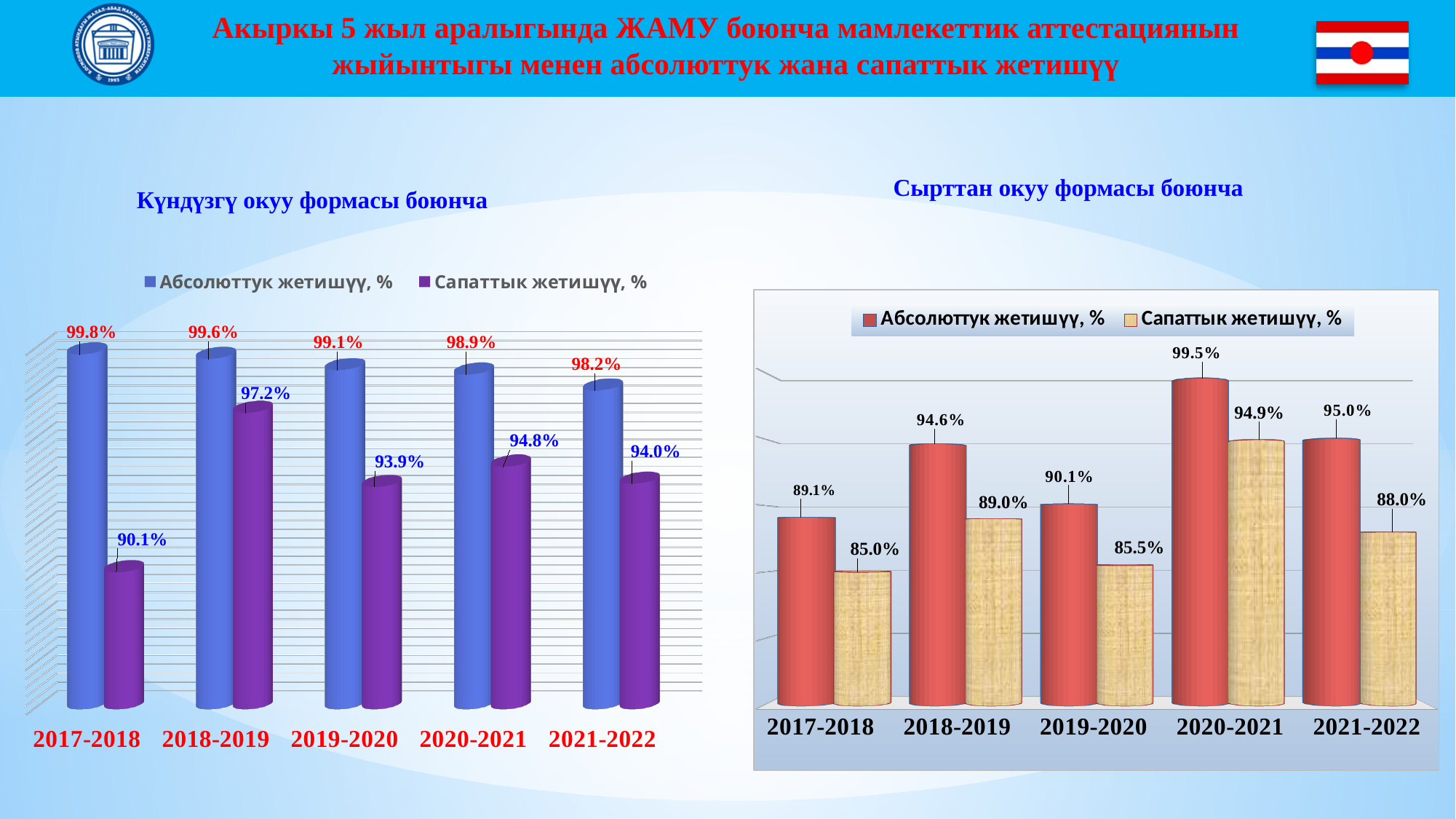
In the right chart (Сырттан окуу формасы боюнча), what is the difference between Абсолюттук жетишүү, % for 2020-2021 and 2017-2018? 10.4% In the left chart (Күндүзгү окуу формасы боюнча), what is the value of Сапаттык жетишүү, % for 2018-2019? 97.2% In the left chart (Күндүзгү окуу формасы боюнча), what is the difference between Абсолюттук жетишүү, % and Сапаттык жетишүү, % for 2021-2022? 4.2% How many years are shown on the x axis of the right chart (Сырттан окуу формасы боюнча)? 5 How many series does the legend of the left chart (Күндүзгү окуу формасы боюнча) list? 2 In the left chart (Күндүзгү окуу формасы боюнча), does Абсолюттук жетишүү, % rise or fall from 2017-2018 to 2021-2022? fall In the right chart (Сырттан окуу формасы боюнча), which is larger: Абсолюттук жетишүү, % for 2018-2019 or for 2021-2022? 2021-2022 In the left chart (Күндүзгү окуу формасы боюнча), which year has the lowest Сапаттык жетишүү, % value? 2017-2018 In the right chart (Сырттан окуу формасы боюнча), what is the value of Абсолюттук жетишүү, % for 2020-2021? 99.5% In the right chart (Сырттан окуу формасы боюнча), which year has the highest Сапаттык жетишүү, % value? 2020-2021 In the right chart (Сырттан окуу формасы боюнча), what is the value of Сапаттык жетишүү, % for 2019-2020? 85.5% In the left chart (Күндүзгү окуу формасы боюнча), what is the value of Абсолюттук жетишүү, % for 2017-2018? 99.8%